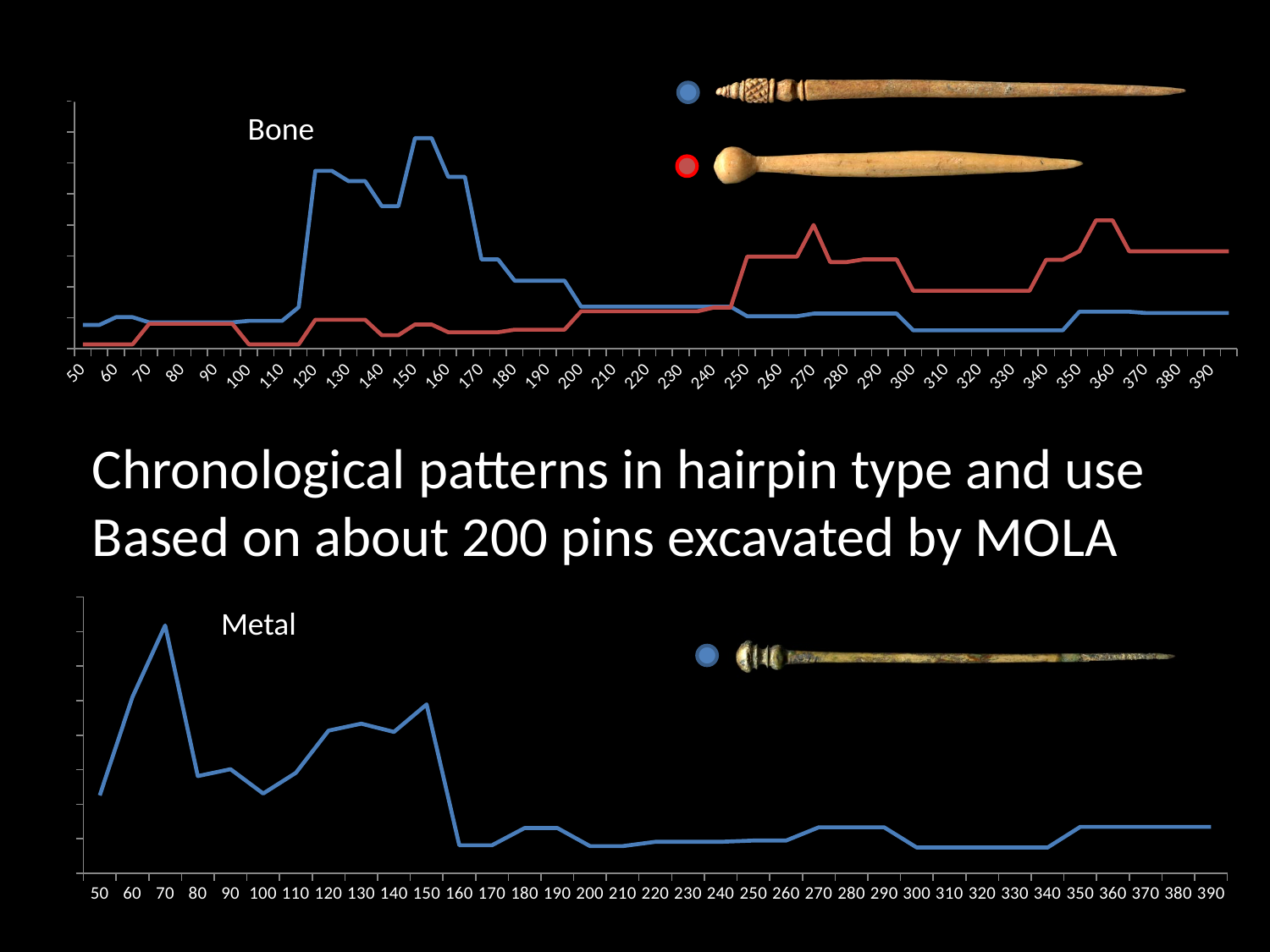
In the Bone chart, at x = 360, which line is higher, the blue or the red? red In the Metal chart, at which x-axis value does the line reach its highest point? 70 In the Metal chart, does the line rise or fall between x = 70 and x = 80? fall How many x-axis tick labels are shown on the Metal chart? 35 What is the first x-axis label on the Bone chart? 50 In the Bone chart, how many lines (series) are plotted? 2 In the Bone chart, at x = 150, which line is higher, the blue or the red? blue What kind of chart is the top chart labelled Bone? line chart What kind of chart is the bottom chart labelled Metal? line chart In the Bone chart, at which x-axis value does the red line reach its highest point? 360 In the Metal chart, how many lines (series) are plotted? 1 In the Metal chart, is the value at 70 higher or lower than the value at 150? higher